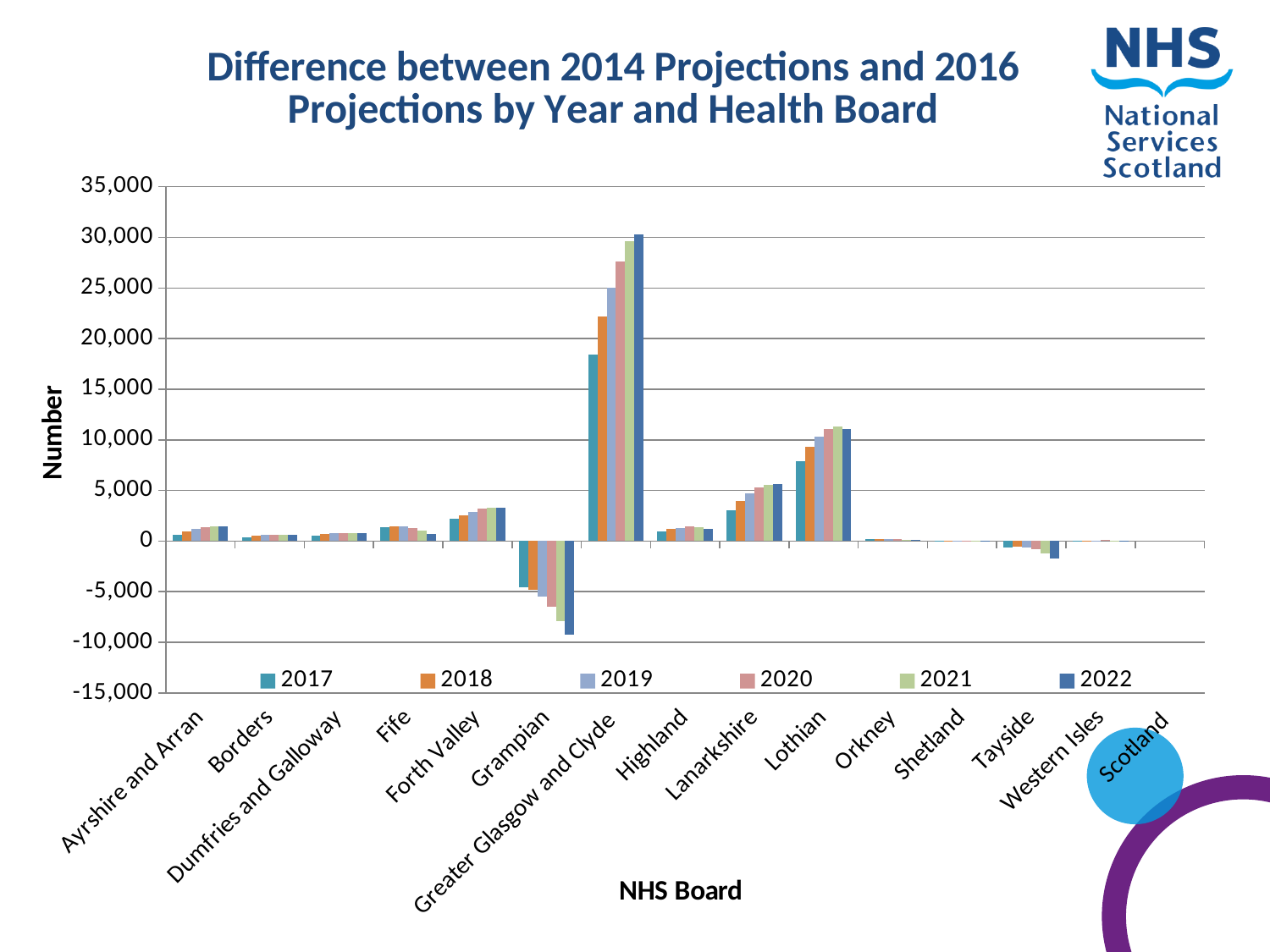
How many series does the legend list? 6 Is the 2017 value for Greater Glasgow and Clyde greater or less than 15,000? greater What kind of chart is shown on the slide? Bar chart Which NHS Board has the highest values on the chart? Greater Glasgow and Clyde Which is larger, the 2022 value for Lothian or the 2022 value for Lanarkshire? Lothian Is the 2022 value for Grampian greater or less than -5,000? less Do the values for Greater Glasgow and Clyde rise or fall from 2017 to 2022? Rise What is the label on the y axis? Number Is the 2021 value for Lothian greater or less than 10,000? greater How many NHS Board categories are shown on the x axis? 15 What is the title of the chart? Difference between 2014 Projections and 2016 Projections by Year and Health Board Which NHS Board has the lowest (most negative) values on the chart? Grampian